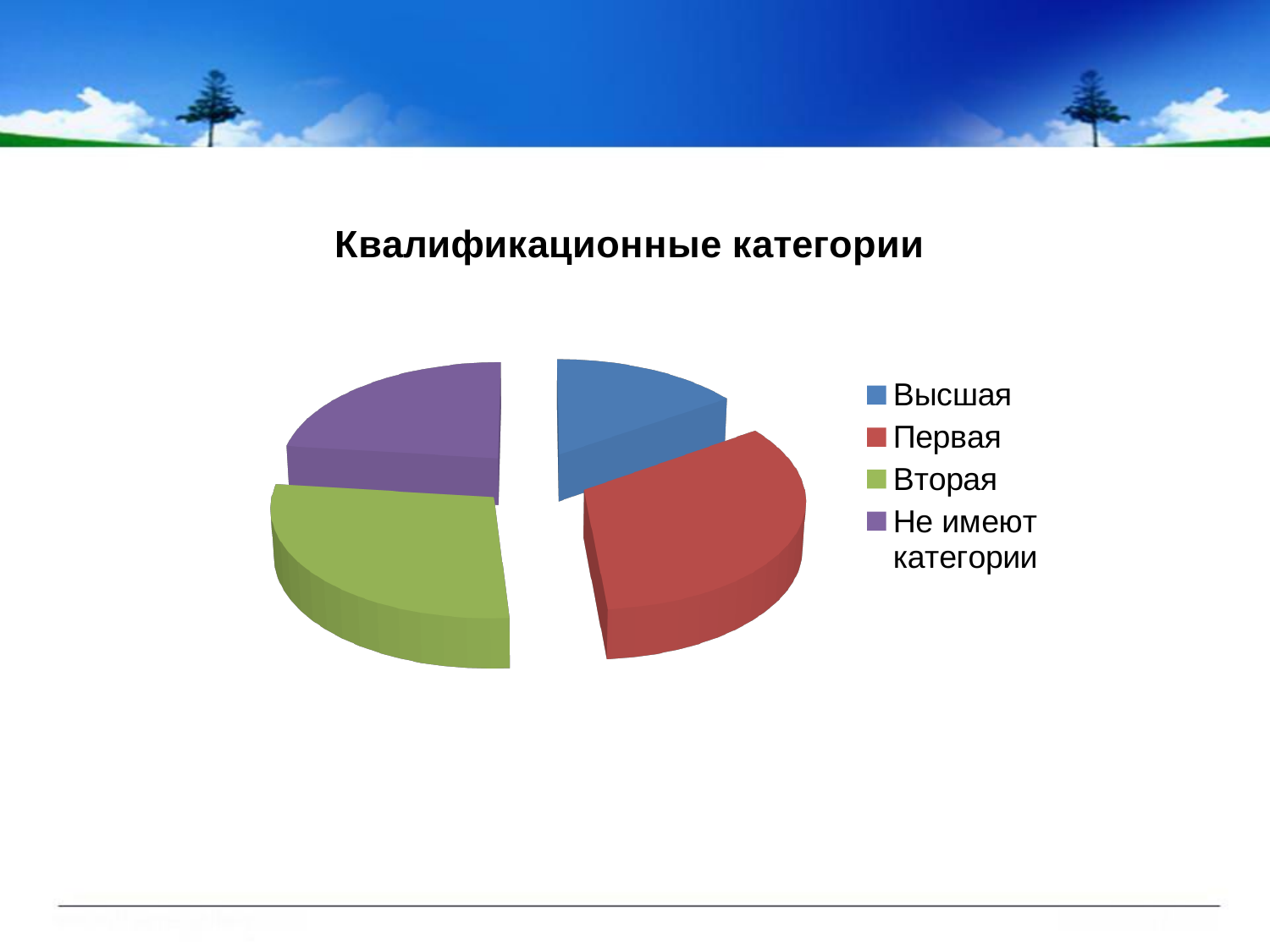
How many slices does the pie chart have? 4 Which slice is larger, Первая or Высшая? Первая What kind of chart is shown on the slide? pie chart Which category has the smallest slice of the pie? Высшая Which slice is larger, Не имеют категории or Высшая? Не имеют категории What is the title of the chart? Квалификационные категории What colour is the slice for Первая? red How many entries does the legend list? 4 Which slice is larger, Вторая or Высшая? Вторая